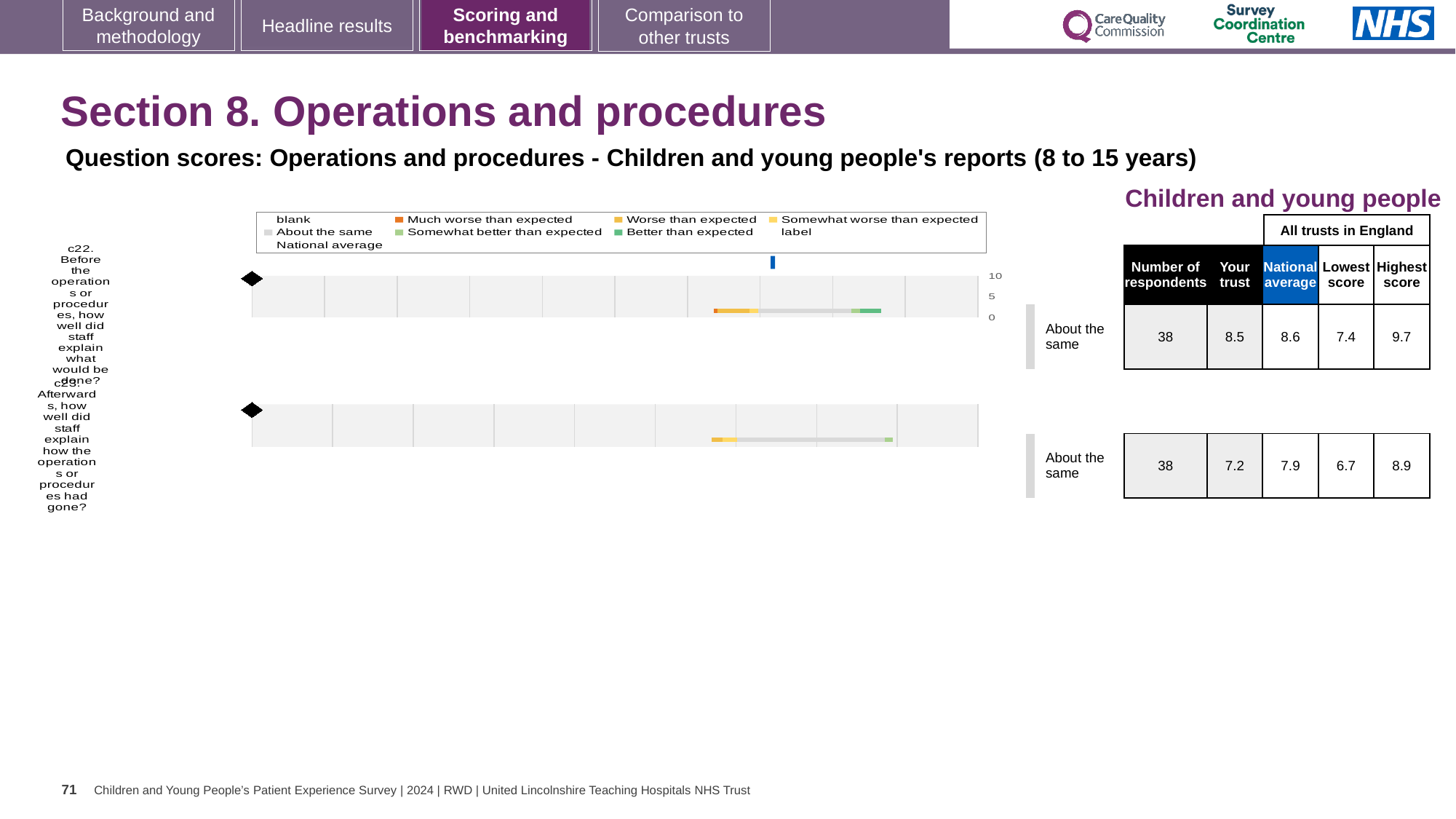
For c23, what is the difference between the Highest score and the Lowest score in the table? 2.2 What colour does the legend use for 'Much worse than expected'? orange In the table next to the c23 chart, what is the National average score? 7.9 What colour does the legend use for 'Better than expected'? green For c22, which is larger: the 'Your trust' score or the National average? National average What kind of chart is used to show the c22 and c23 question scores? bar chart How many survey questions (c22, c23) are plotted on the slide? 2 In the table next to the c22 chart, what is the 'Your trust' score? 8.5 In the table next to the c23 chart, what is the Lowest score among all trusts in England? 6.7 What benchmark category is shown beside both the c22 and c23 charts? About the same In the table next to the c22 chart, what is the Highest score among all trusts in England? 9.7 How many entries does the chart legend list? 9